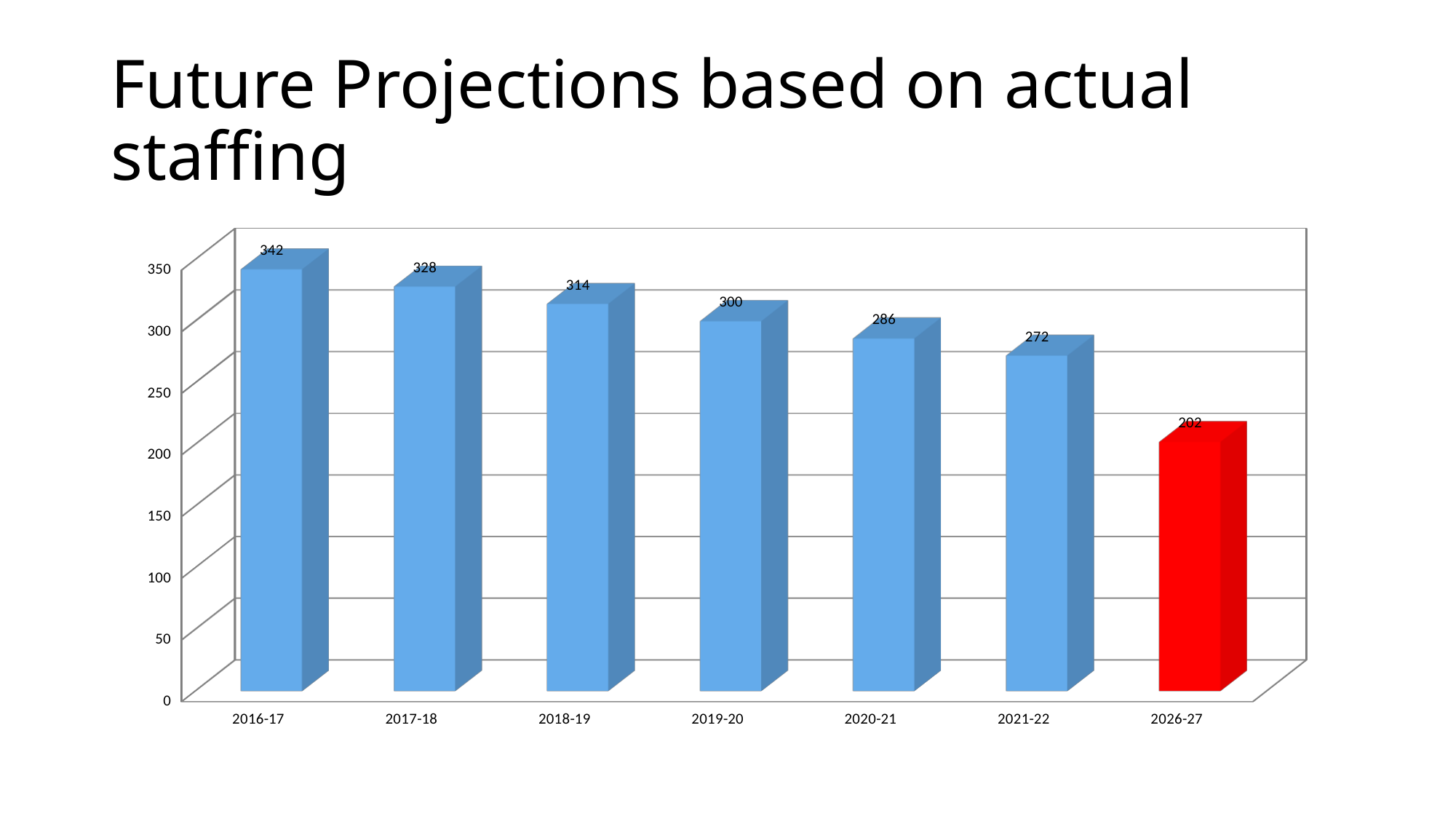
Which year has the lowest value? 2026-27 What is the difference between the values for 2017-18 and 2018-19? 14 Which is larger, the value for 2020-21 or the value for 2021-22? 2020-21 What is the difference between the values for 2016-17 and 2026-27? 140 Is the value for 2021-22 greater or less than 250? greater What is the value for 2019-20? 300 What is the value for 2026-27? 202 What is the value for 2016-17? 342 What kind of chart is shown on the slide? bar chart How many years are shown on the x axis? 7 Do the values rise or fall from 2016-17 to 2026-27? fall Which year has the highest value? 2016-17